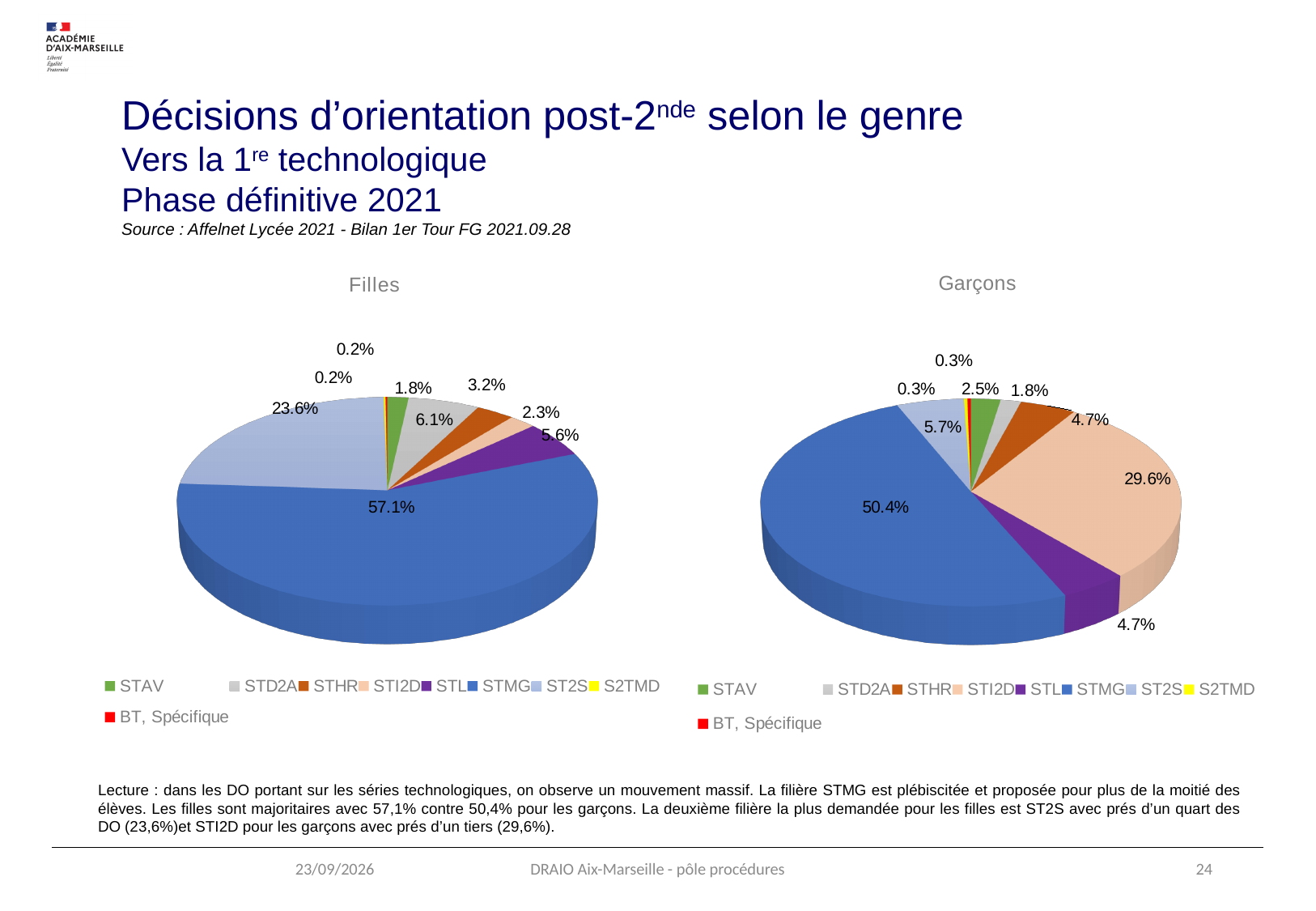
What is the title of the chart on the right of the slide? Garçons What is the difference between the STMG share in the Filles chart and the STMG share in the Garçons chart? 6.7 percentage points In the Garçons chart, which category has the largest slice? STMG Which is larger: the STD2A share in the Filles chart or the STD2A share in the Garçons chart? Filles In the Garçons chart, what is the value for ST2S? 5.7% In the Garçons chart, what share of the pie is STI2D? 29.6% How many series does the legend of the Garçons chart list? 9 What type of chart is the Filles chart? Pie chart In the Filles chart, what is the value for ST2S? 23.6% In the Filles chart, what share of the pie is STMG? 57.1% In the Filles chart, what is the value for STL? 5.6% In the Filles chart, which category has the largest slice? STMG